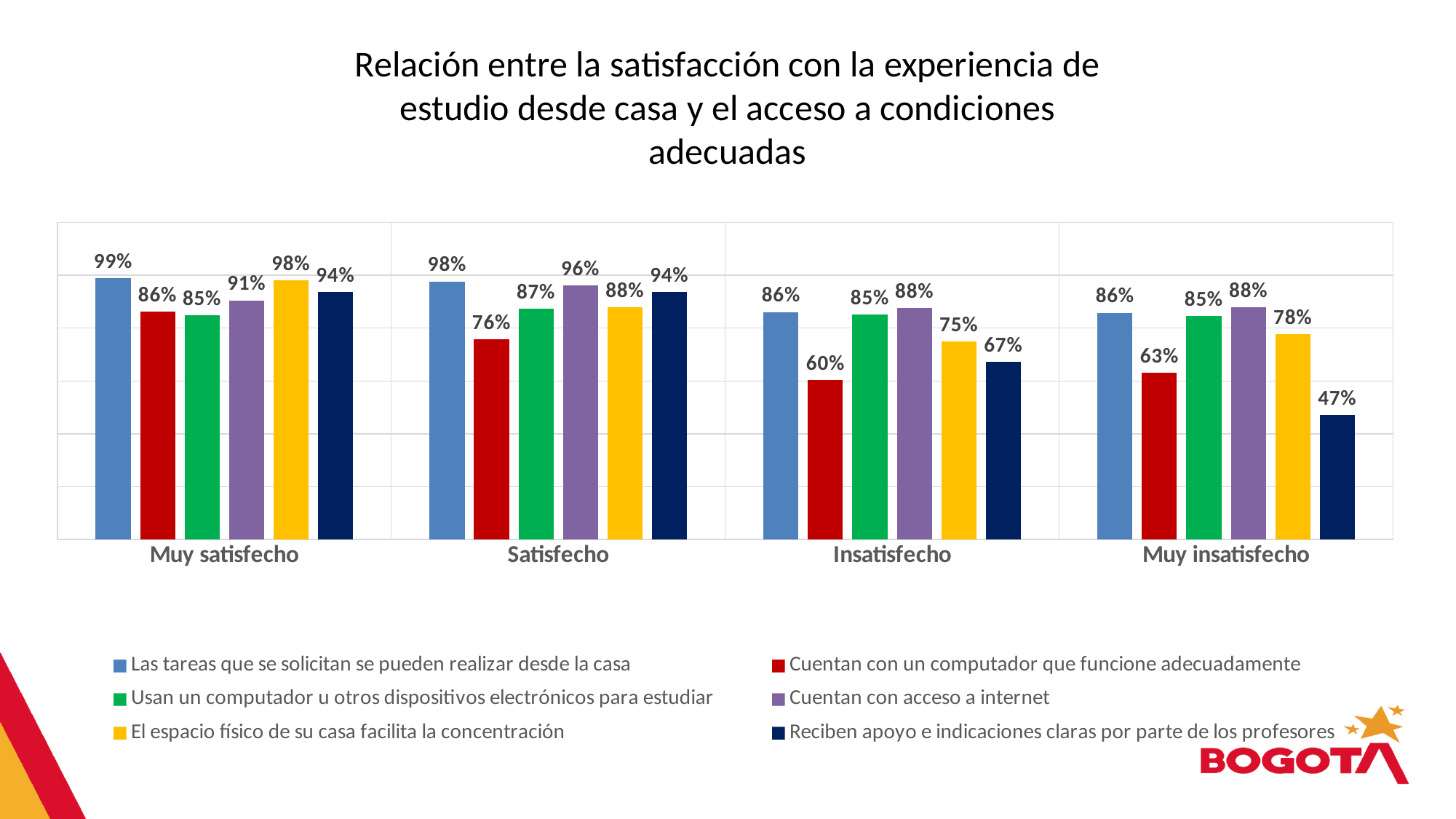
What is the value for 'El espacio físico de su casa facilita la concentración' in the 'Muy satisfecho' category? 98% How does the value for 'Reciben apoyo e indicaciones claras por parte de los profesores' change from 'Muy satisfecho' to 'Muy insatisfecho'? It falls What type of chart is shown on the slide? Bar chart How many satisfaction categories are shown on the x axis? 4 What is the value for 'Cuentan con un computador que funcione adecuadamente' in the 'Insatisfecho' category? 60% What is the difference between the 'Cuentan con acceso a internet' values for 'Muy satisfecho' and 'Insatisfecho'? 3% How many series does the legend list? 6 Which is larger: the 'Cuentan con un computador que funcione adecuadamente' value for 'Satisfecho' or for 'Muy insatisfecho'? Satisfecho Which colour represents 'Cuentan con acceso a internet' in the legend? Purple Which series has the lowest value in the 'Muy insatisfecho' category? Reciben apoyo e indicaciones claras por parte de los profesores What is the value for 'Reciben apoyo e indicaciones claras por parte de los profesores' in the 'Muy insatisfecho' category? 47% Which series has the highest value in the 'Satisfecho' category? Las tareas que se solicitan se pueden realizar desde la casa